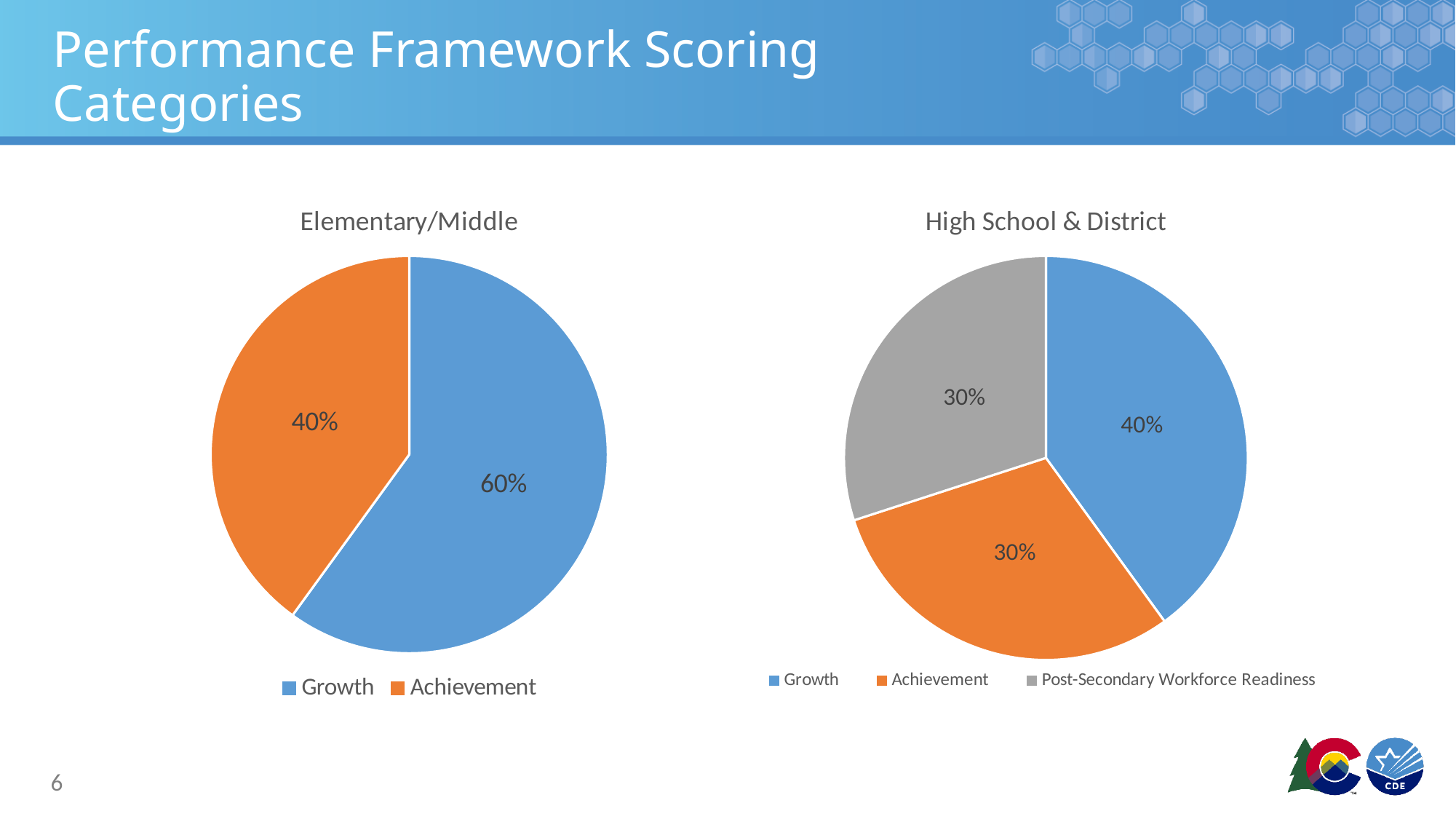
In the High School & District chart, what share does Post-Secondary Workforce Readiness have? 30% In the High School & District chart, what share does Growth have? 40% In the Elementary/Middle chart, which is larger, Growth or Achievement? Growth In the Elementary/Middle chart, what is the difference between the Growth and Achievement shares? 20% In the High School & District chart, which category has the largest slice? Growth How many entries does the legend of the Elementary/Middle chart list? 2 What type of chart is the High School & District chart? Pie chart In the High School & District chart, what is the difference between the Growth and Achievement shares? 10% In the Elementary/Middle chart, what share does Achievement have? 40% In the Elementary/Middle chart, which category has the largest slice? Growth How many slices does the High School & District chart have? 3 In the Elementary/Middle chart, what share does Growth have? 60%